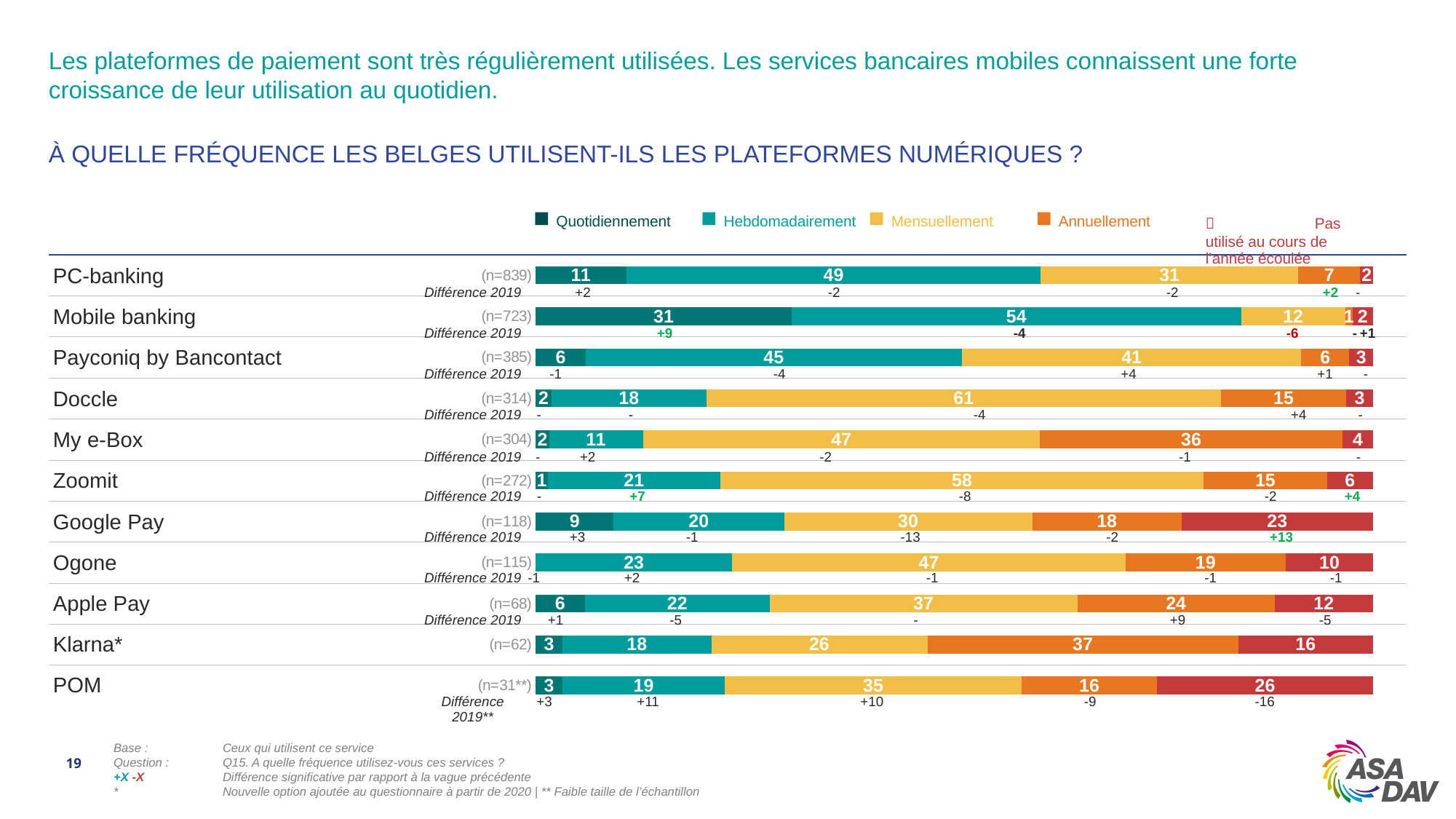
Which has a larger Annuellement value, Klarna* or Apple Pay? Klarna* What is the difference between the Hebdomadairement values of Mobile banking and PC-banking? 5 What is the Mensuellement value for Doccle? 61 What is the Annuellement value for My e-Box? 36 Which platform has the lowest Mensuellement value? Mobile banking What percentage of Mobile banking users use it Quotidiennement (daily)? 31 How many platforms are shown in the chart? 11 How many series does the legend list? 5 Which platform has the highest Quotidiennement value? Mobile banking Which platform has the highest value for 'Pas utilisé au cours de l'année écoulée'? POM What kind of chart is shown on the slide? Stacked bar chart What is the sample size (n) shown for PC-banking? n=839